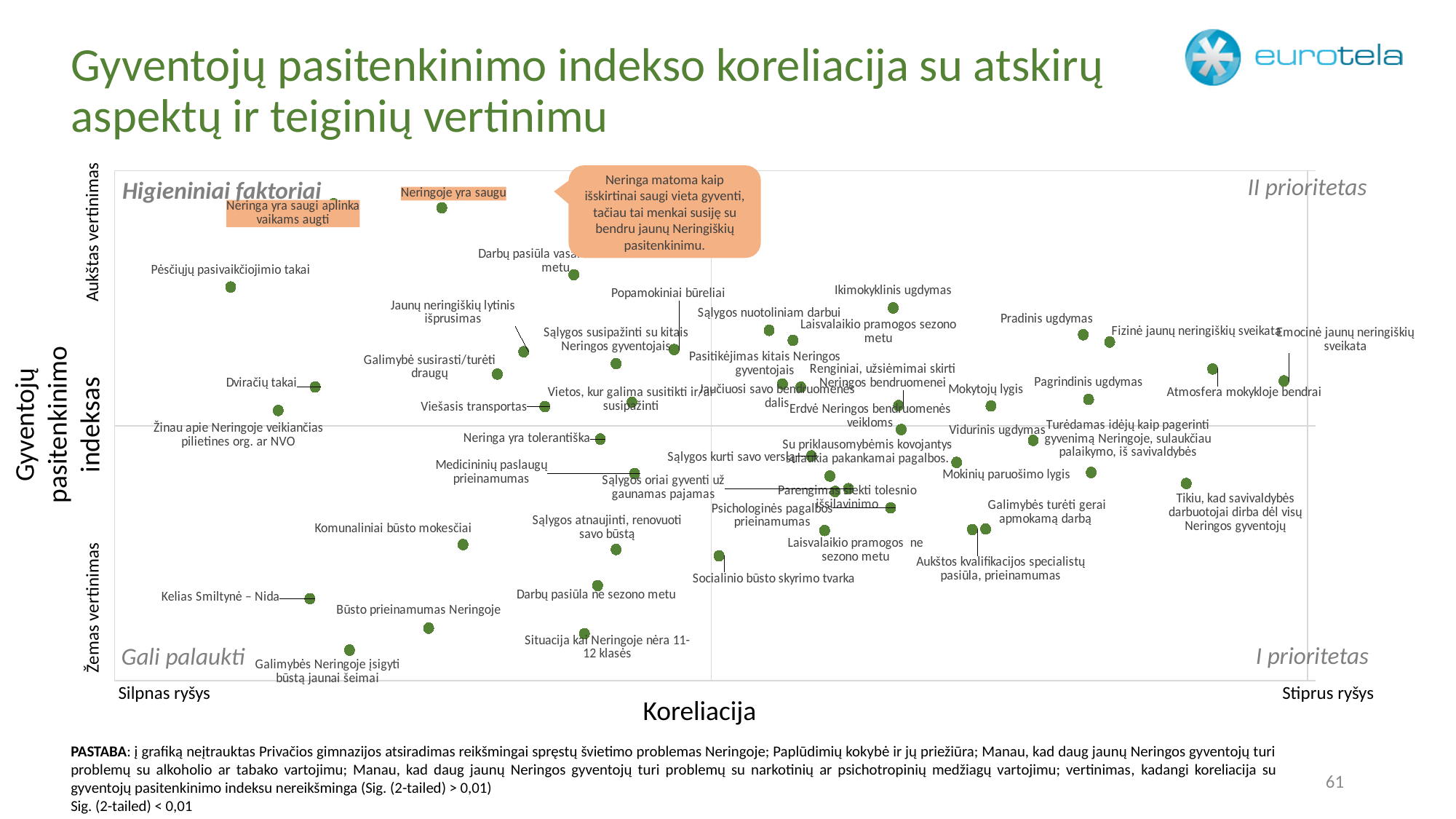
What kind of chart is shown on the slide? Scatter chart Which point is plotted furthest to the right on the Koreliacija axis? Emocinė jaunų neringiškių sveikata Which is plotted higher on the vertical axis: 'Neringa yra saugi aplinka vaikams augti' or 'Kelias Smiltynė – Nida'? Neringa yra saugi aplinka vaikams augti Which is plotted further right on the Koreliacija axis: 'Ikimokyklinis ugdymas' or 'Dviračių takai'? Ikimokyklinis ugdymas Which point is plotted furthest to the left on the Koreliacija axis? Pėsčiųjų pasivaikščiojimio takai What label is shown in the bottom-right quadrant of the chart? I prioritetas Which is plotted higher on the vertical axis: 'Pradinis ugdymas' or 'Socialinio būsto skyrimo tvarka'? Pradinis ugdymas What is the label of the horizontal axis of the chart? Koreliacija Which point is plotted lowest on the vertical axis? Galimybės Neringoje įsigyti būstą jaunai šeimai Which point is plotted highest on the vertical axis (Gyventojų pasitenkinimo indeksas)? Neringa yra saugi aplinka vaikams augti